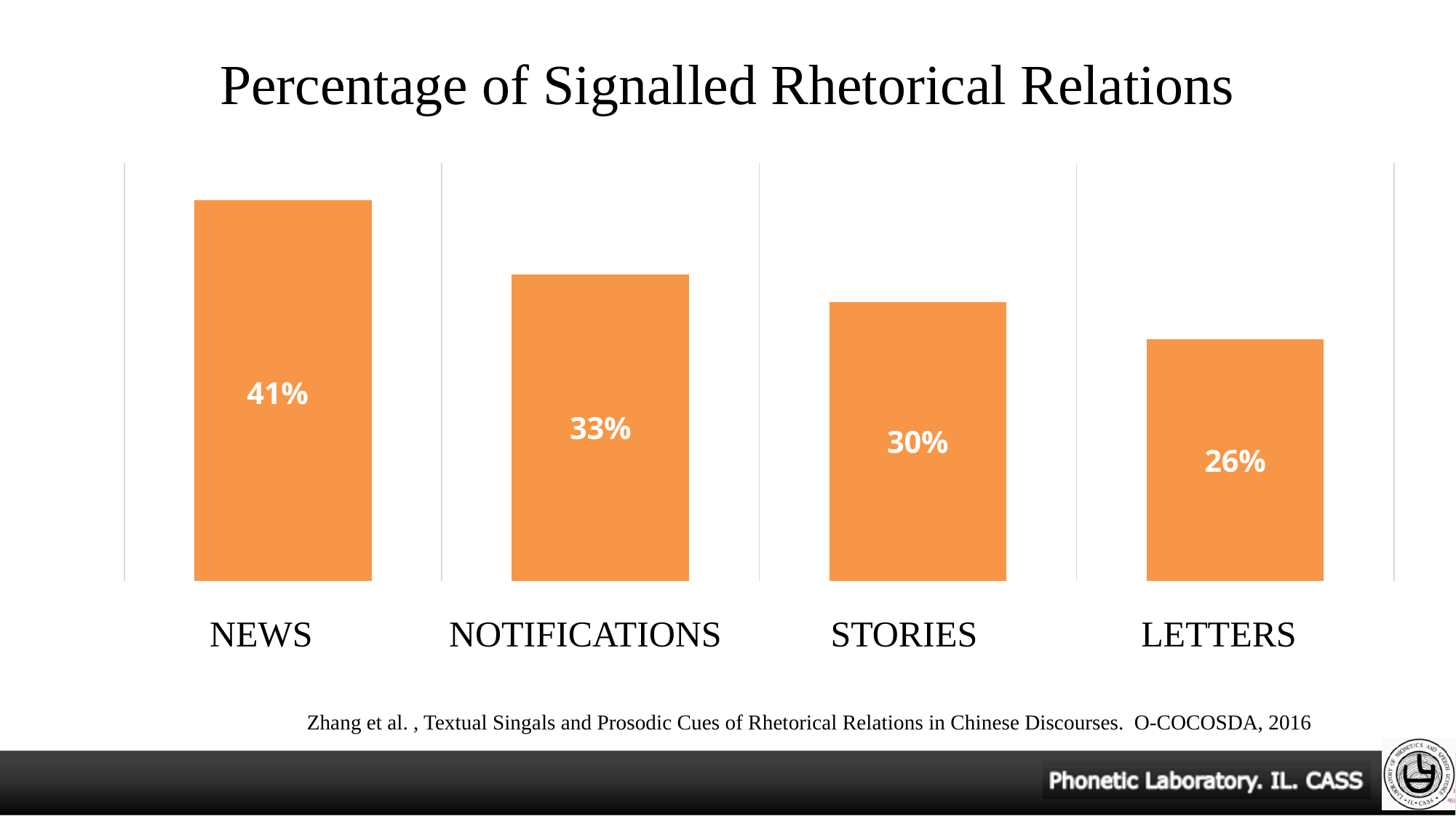
What is the percentage of signalled rhetorical relations for STORIES? 30% What kind of chart is shown on the slide? Bar chart Which category has the highest percentage of signalled rhetorical relations? NEWS What is the difference in percentage points between NOTIFICATIONS and STORIES? 3 Which category has the lowest percentage of signalled rhetorical relations? LETTERS What is the percentage of signalled rhetorical relations for NOTIFICATIONS? 33% What is the percentage of signalled rhetorical relations for LETTERS? 26% What is the percentage of signalled rhetorical relations for NEWS? 41% Which has a higher percentage of signalled rhetorical relations, NOTIFICATIONS or STORIES? NOTIFICATIONS Do the values rise or fall from left to right across the categories? Fall What is the difference in percentage points between NEWS and LETTERS? 15 How many categories are shown in the chart? 4